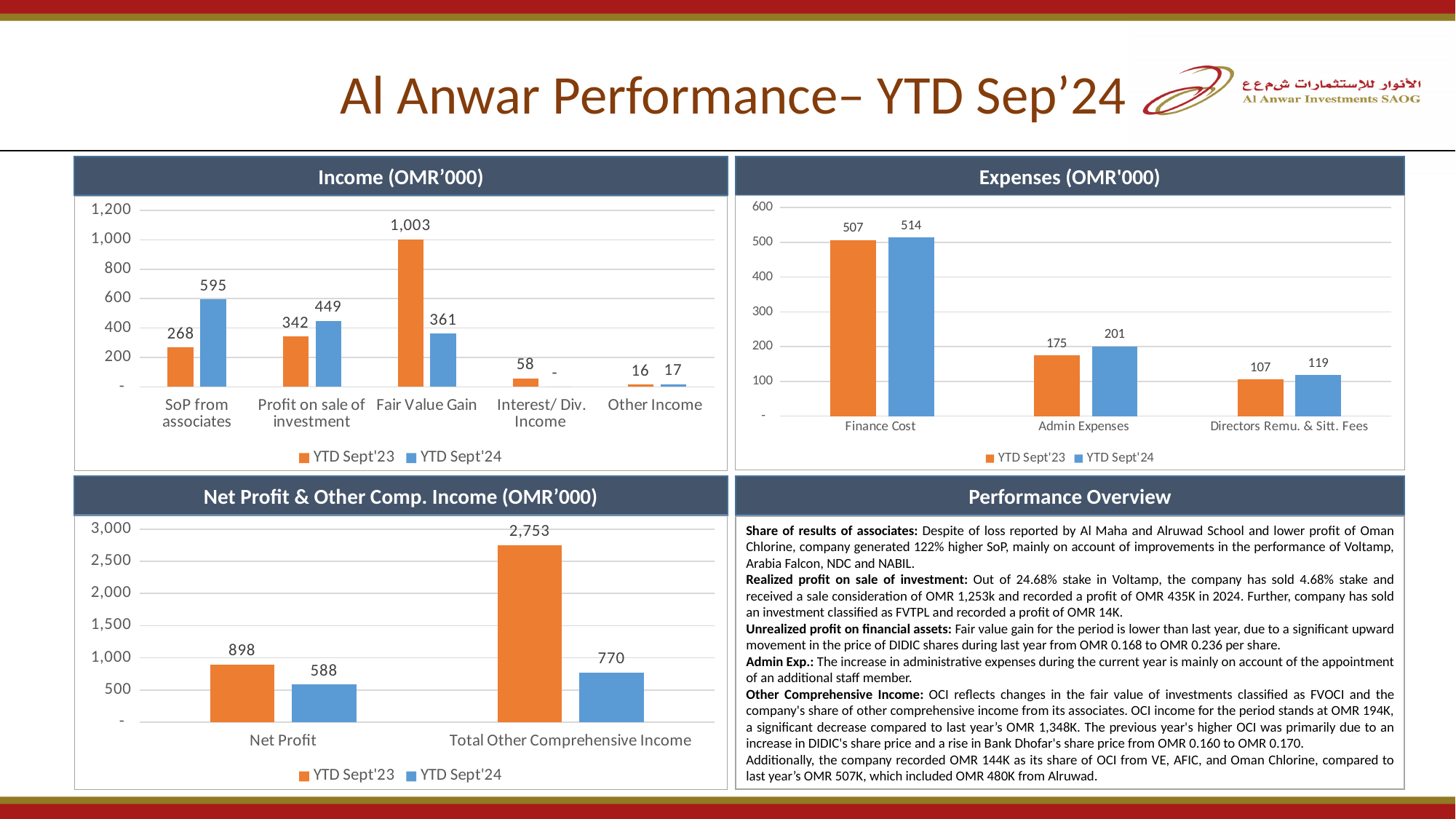
In the Income (OMR'000) chart, what is the YTD Sept'23 value for Fair Value Gain? 1,003 In the Income (OMR'000) chart, which category has the highest YTD Sept'23 value? Fair Value Gain In the Net Profit & Other Comp. Income (OMR'000) chart, which is larger for Net Profit: YTD Sept'23 or YTD Sept'24? YTD Sept'23 In the Net Profit & Other Comp. Income (OMR'000) chart, how many series does the legend list? 2 In the Income (OMR'000) chart, how many categories are shown on the x axis? 5 In the Net Profit & Other Comp. Income (OMR'000) chart, what is the YTD Sept'23 value for Total Other Comprehensive Income? 2,753 In the Income (OMR'000) chart, what is the YTD Sept'24 value for SoP from associates? 595 In the Expenses (OMR'000) chart, what is the YTD Sept'24 value for Admin Expenses? 201 In the Expenses (OMR'000) chart, what is the difference between the YTD Sept'24 and YTD Sept'23 values for Finance Cost? 7 In the Income (OMR'000) chart, what is the difference between the YTD Sept'24 and YTD Sept'23 values for Profit on sale of investment? 107 What type of chart is the Expenses (OMR'000) chart? Bar chart In the Expenses (OMR'000) chart, which category has the lowest YTD Sept'23 value? Directors Remu. & Sitt. Fees